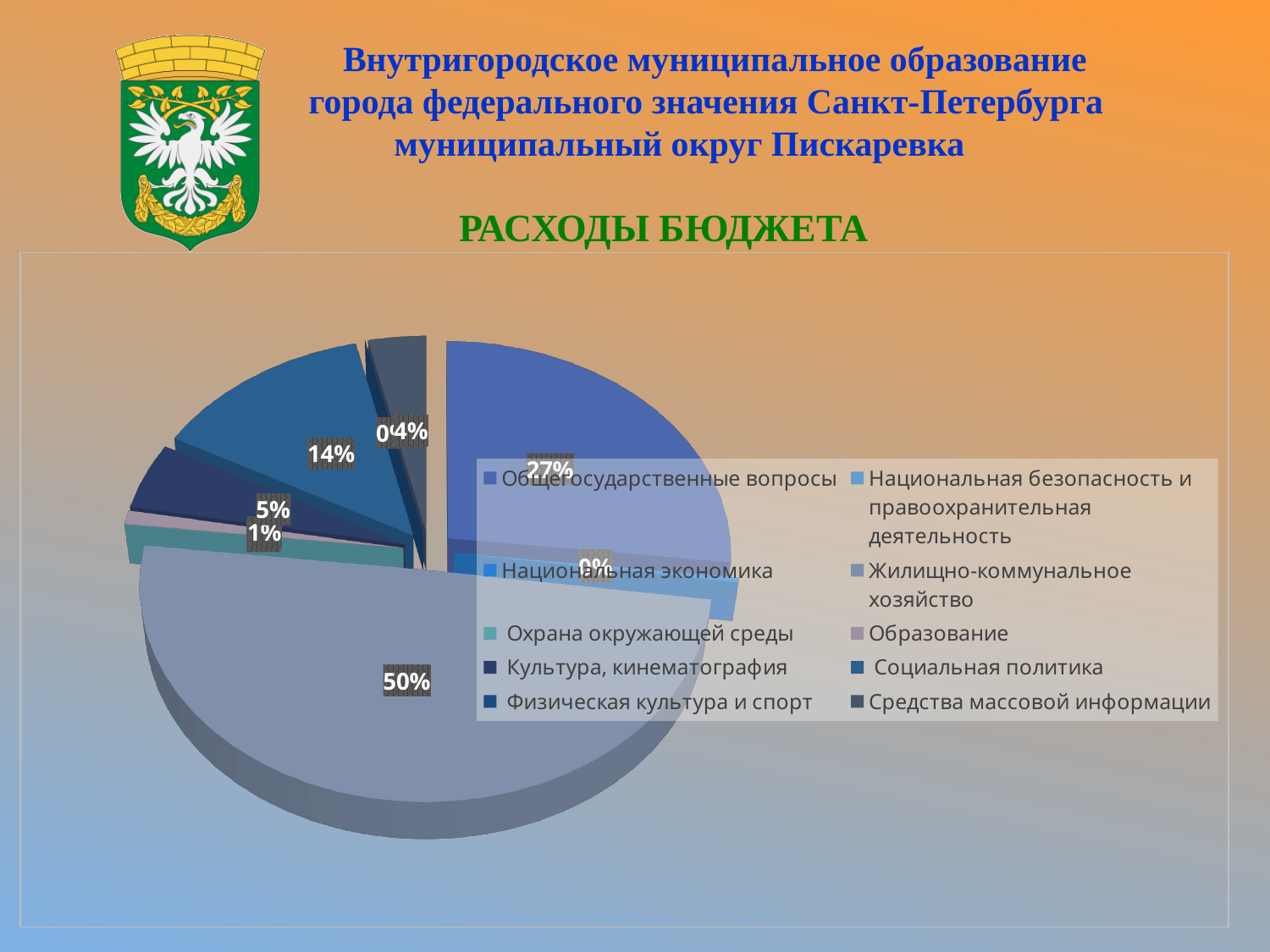
What is the largest percentage shown on the pie chart? 50% Which legend entry is listed first in the chart legend? Общегосударственные вопросы What kind of chart is shown on the slide? pie chart How many categories does the chart legend list? 10 What share of the pie does Жилищно-коммунальное хозяйство take? 50% What is the difference in percentage points between the 50% slice and the 27% slice? 23 Is the share for Жилищно-коммунальное хозяйство greater or less than 40%? greater Which is larger, the slice labelled 14% or the slice labelled 5%? 14% What share of the pie does Общегосударственные вопросы take? 27% What is the title of the chart on the slide? РАСХОДЫ БЮДЖЕТА